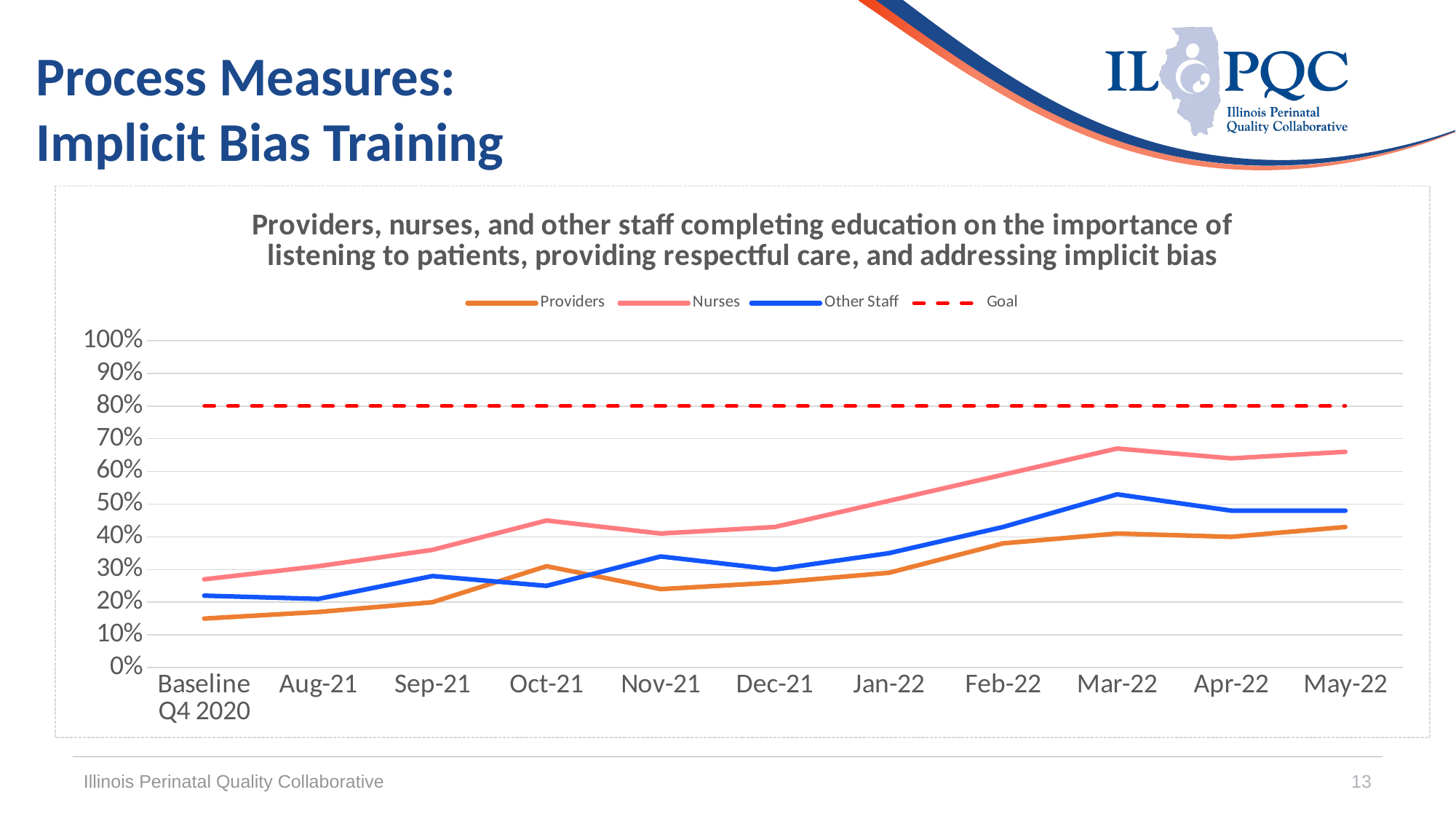
How many time points are plotted along the x axis? 11 Is the value for Other Staff in Mar-22 greater or less than 40%? greater What kind of chart is shown on the slide? line chart Which legend entry is drawn as a red dashed line? Goal In Oct-21, which is larger: the value for Providers or the value for Other Staff? Providers Is the value for Providers at Baseline Q4 2020 greater or less than 20%? less Which series has the highest value in May-22? Nurses Is the value for Nurses in May-22 greater or less than 60%? greater At what percentage does the dashed Goal line sit? 80% Does the Nurses line generally rise or fall from Baseline Q4 2020 to Mar-22? rise How many series does the chart legend list? 4